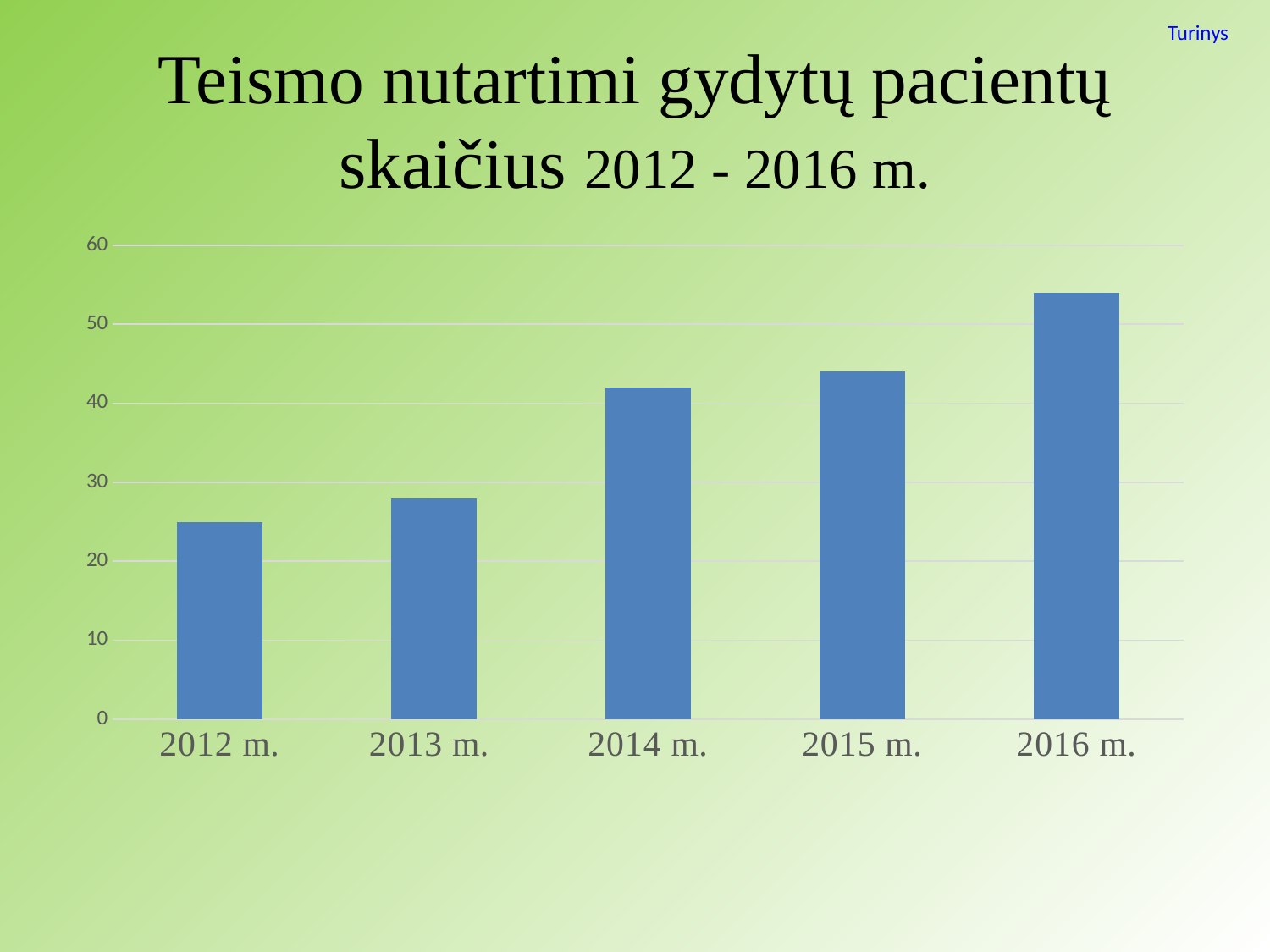
Is the value for 2015 m. greater or less than 40? greater Is the value for 2013 m. greater or less than 20? greater Which year has the highest number of patients treated by court order? 2016 m. Which is larger, the value for 2013 m. or the value for 2014 m.? 2014 m. Is the value for 2016 m. greater or less than 50? greater What is the title of the chart on the slide? Teismo nutartimi gydytų pacientų skaičius 2012 - 2016 m. How many years (categories) are shown on the x axis? 5 What kind of chart is shown on the slide? bar chart Which year has the lowest number of patients treated by court order? 2012 m. Do the values rise or fall from 2012 m. to 2016 m.? rise